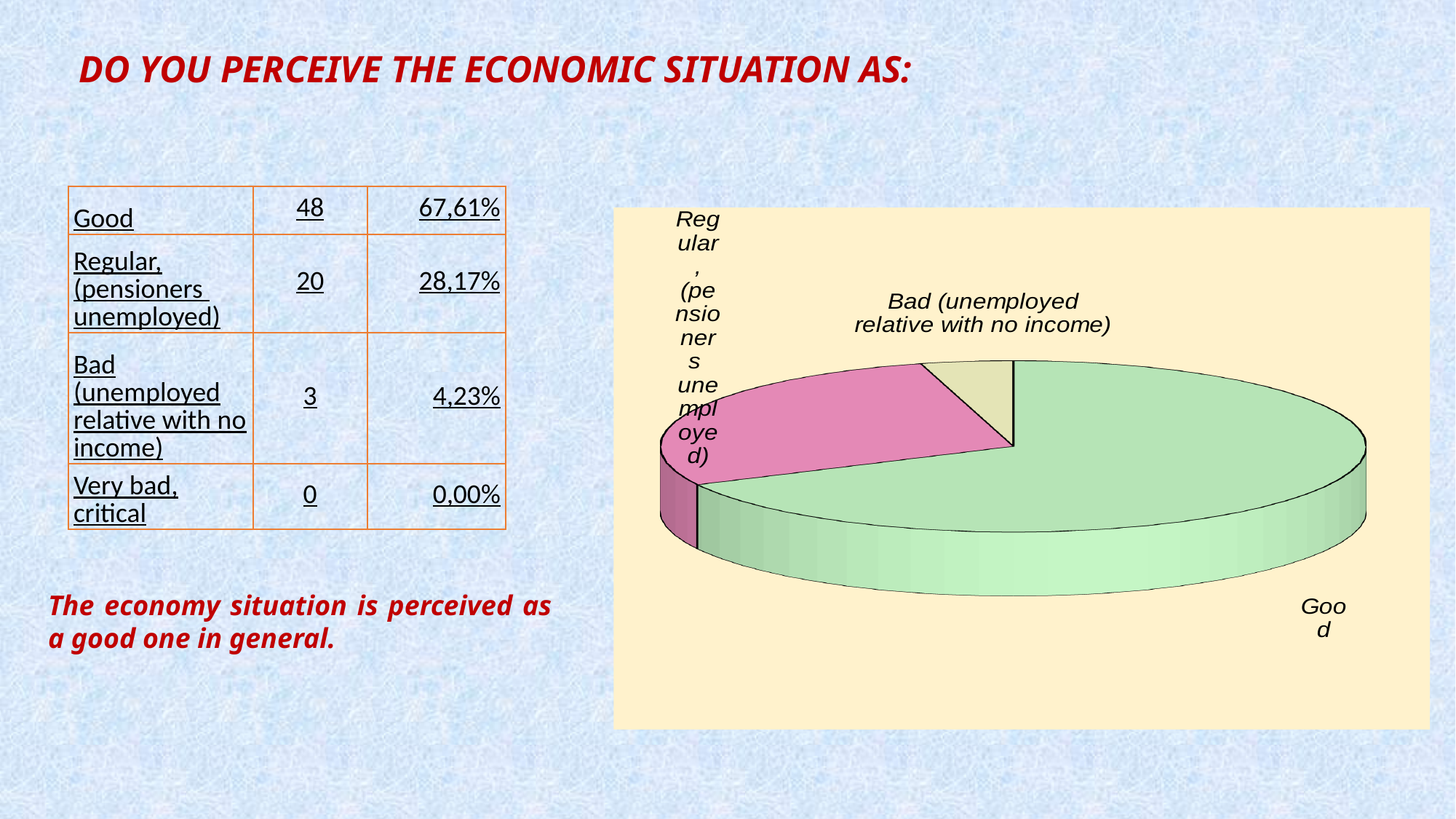
What is the title of the slide above the chart? DO YOU PERCEIVE THE ECONOMIC SITUATION AS: What is the difference in respondent counts between Good and Regular (pensioners unemployed)? 28 According to the table, what percentage of respondents perceive the economic situation as Good? 67,61% What colour is the Good slice of the pie chart? green Which category has the largest slice of the pie chart? Good How many categories does the table list? 4 According to the table, how many respondents answered Very bad, critical? 0 According to the table, what percentage corresponds to Bad (unemployed relative with no income)? 4,23% What kind of chart is shown on the slide? pie chart Is the Good slice larger or smaller than the Regular (pensioners unemployed) slice? larger Which visible slice of the pie chart is the smallest? Bad (unemployed relative with no income) According to the table, how many respondents answered Regular (pensioners unemployed)? 20